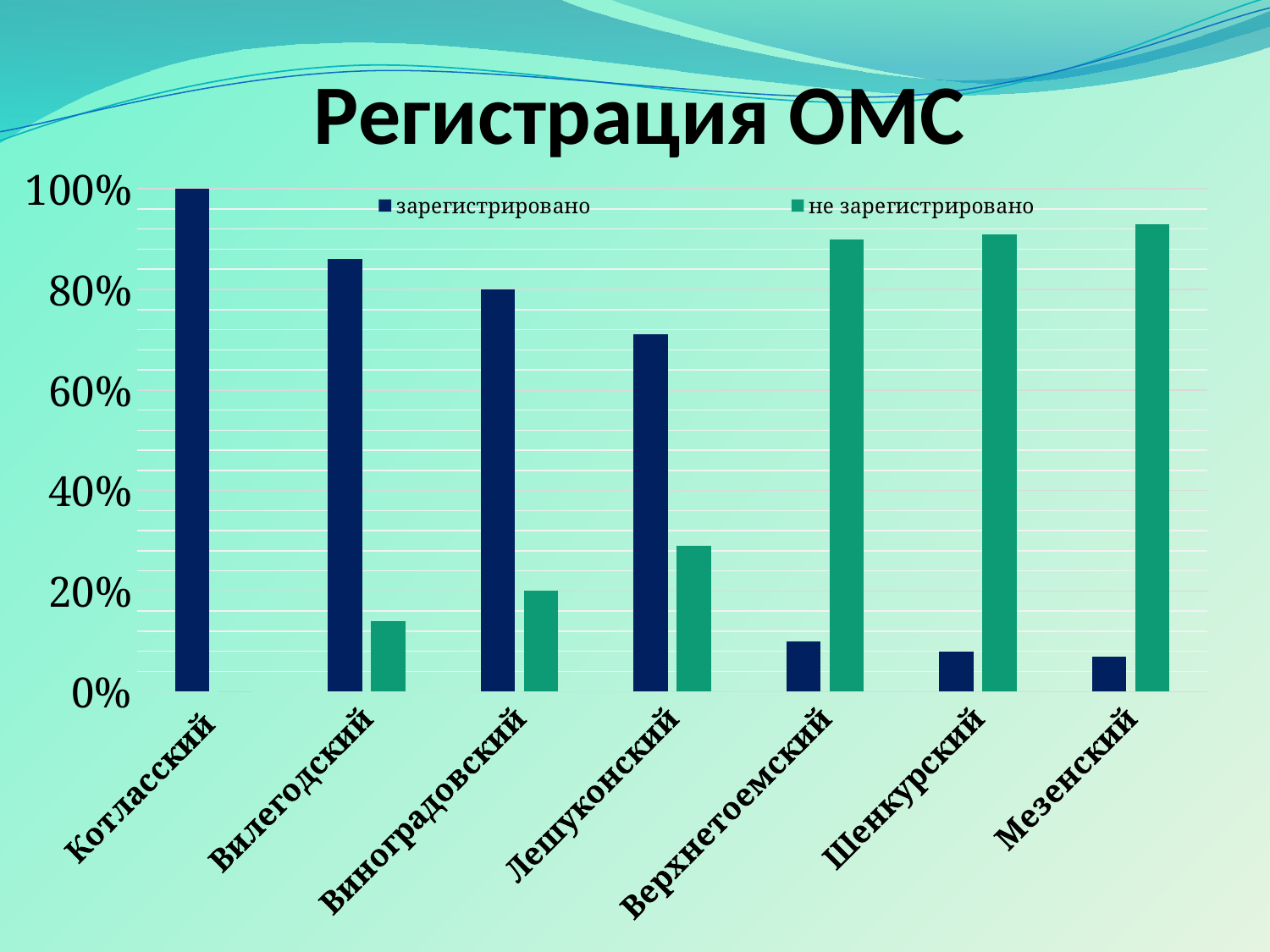
Do the 'зарегистрировано' values rise or fall moving from left to right along the x axis? fall Is the 'не зарегистрировано' value for Верхнетоемский greater or less than 80%? greater How many districts (categories) are shown on the x axis? 7 Is the 'зарегистрировано' value for Вилегодский greater or less than 80%? greater For Шенкурский, which is larger: 'зарегистрировано' or 'не зарегистрировано'? не зарегистрировано How many series does the legend list? 2 What is the title of the chart? Регистрация ОМС What kind of chart is shown on the slide? bar chart Which district has the highest 'зарегистрировано' value? Котласский Is the 'зарегистрировано' value for Лешуконский greater or less than 80%? less What is the value of 'зарегистрировано' for Котласский? 100%